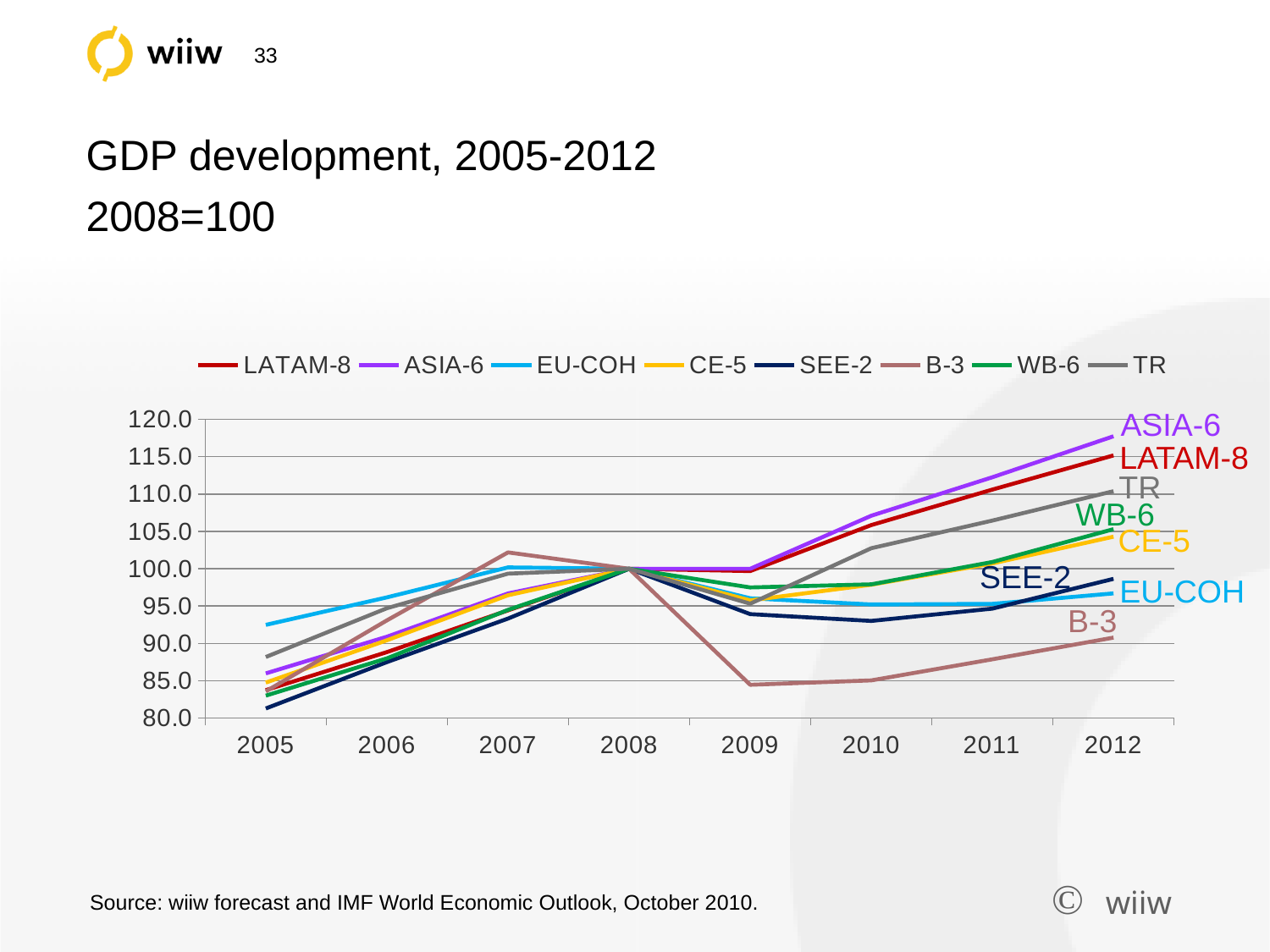
Is the value for B-3 in 2009 greater or less than 90? less How many series does the legend list? 8 Which series has the highest value in 2012? ASIA-6 In 2012, which is larger, LATAM-8 or TR? LATAM-8 What is the title of the chart? GDP development, 2005-2012 What kind of chart is shown on the slide? line chart Is the value for ASIA-6 in 2012 greater or less than 115? greater Which series has the lowest value in 2012? B-3 What is the value of every series in 2008? 100.0 Does the B-3 line rise or fall from 2008 to 2009? fall Which series has the highest value in 2005? EU-COH How many years are shown along the x axis? 8